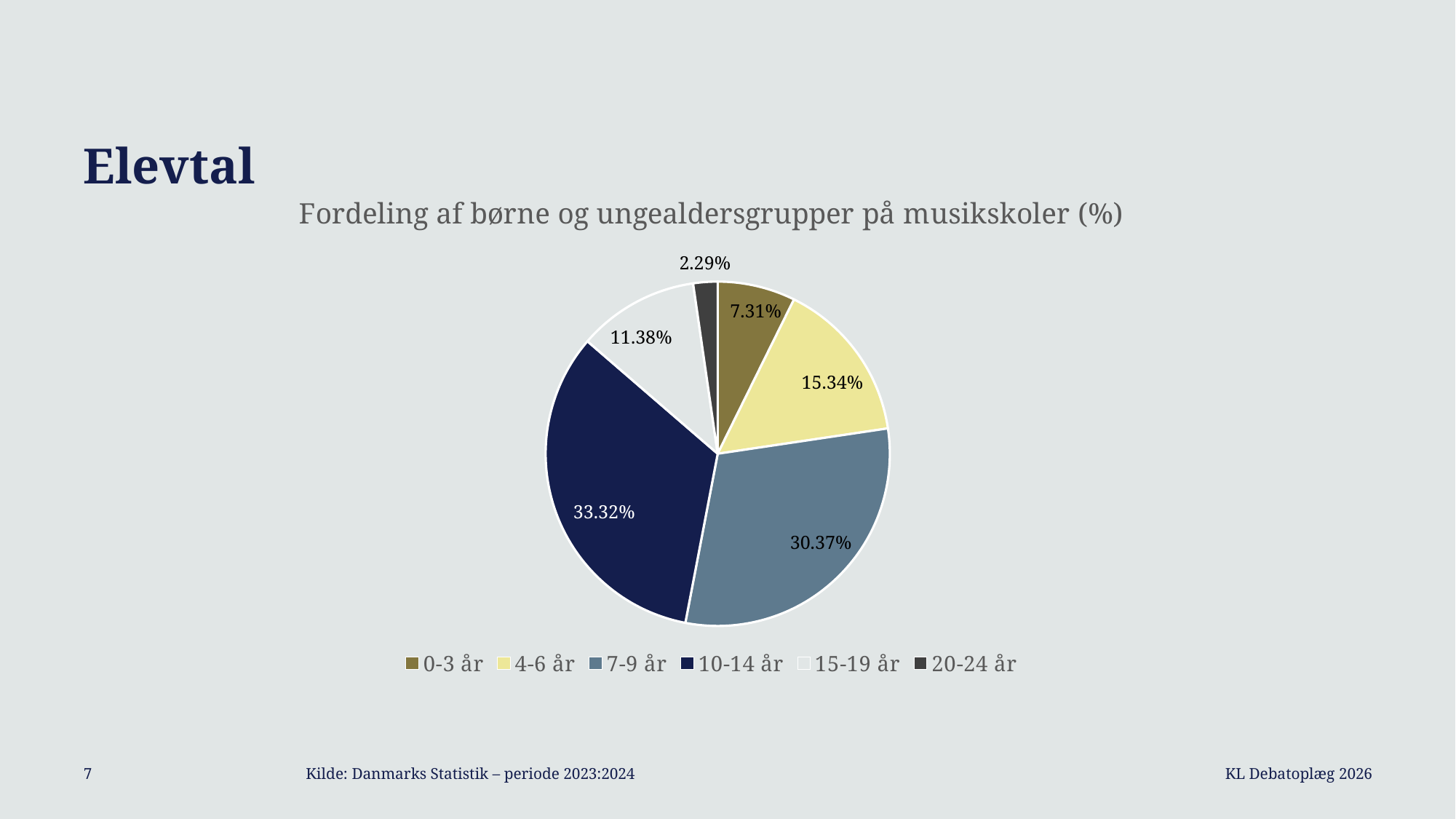
What share of the pie does the 10-14 år group have? 33.32% Which age group has the smallest share of the pie? 20-24 år What kind of chart is shown on the slide? Pie chart How many age groups does the pie chart show? 6 What is the difference between the shares of the 15-19 år and 20-24 år groups? 9.09% What is the value for the 7-9 år group? 30.37% Which age group has the largest share of the pie? 10-14 år What is the title of the chart? Fordeling af børne og ungealdersgrupper på musikskoler (%) What is the value for the 20-24 år group? 2.29% What is the difference between the shares of the 10-14 år and 7-9 år groups? 2.95% What is the value for the 0-3 år group? 7.31% Which is larger, the share for 4-6 år or the share for 15-19 år? 4-6 år